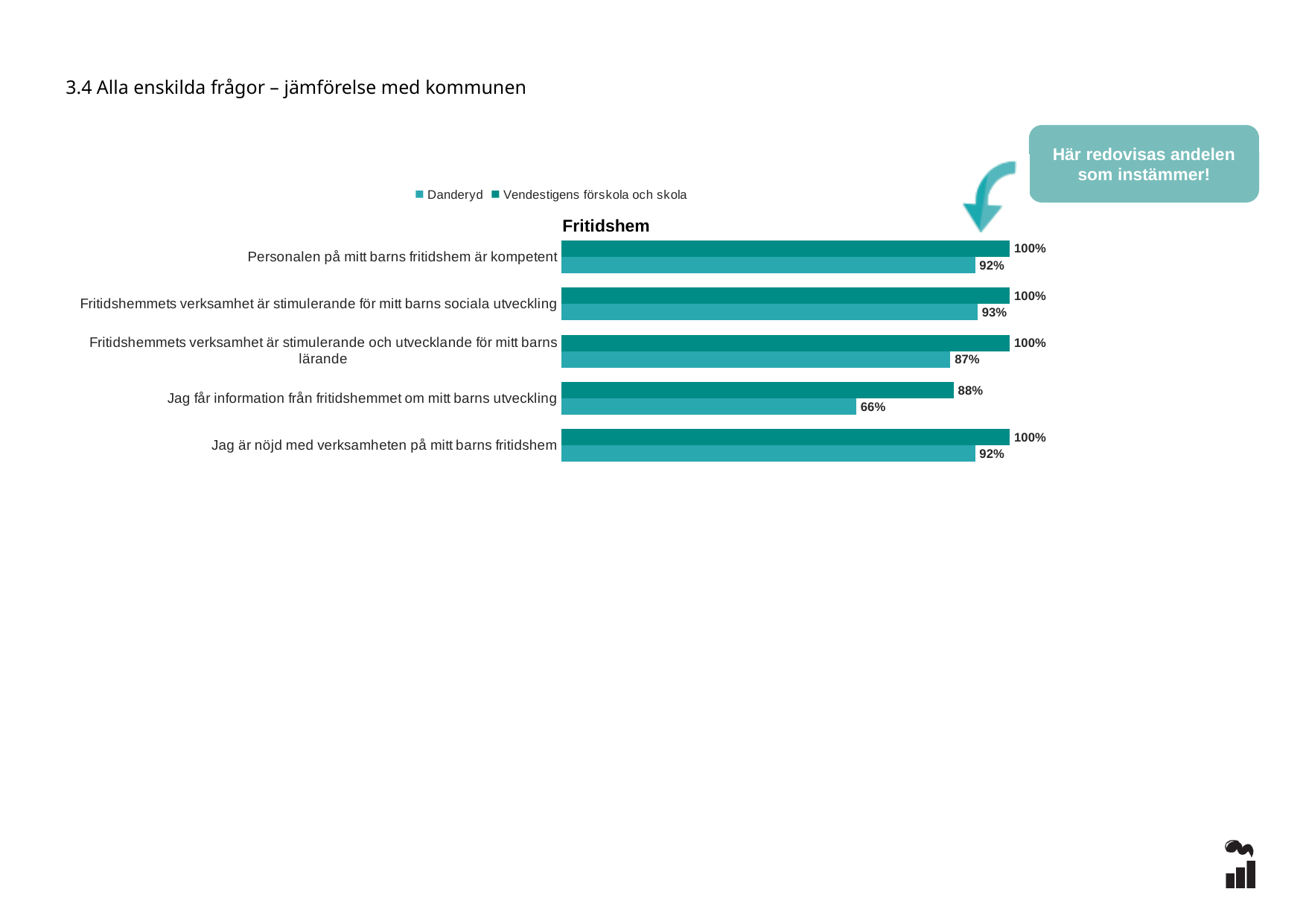
Which statement has the lowest Danderyd value? Jag får information från fritidshemmet om mitt barns utveckling What is the Danderyd value for "Jag får information från fritidshemmet om mitt barns utveckling"? 66% What is the Vendestigens förskola och skola value for "Jag får information från fritidshemmet om mitt barns utveckling"? 88% How many statements (categories) are plotted in the Fritidshem chart? 5 What is the difference between the Vendestigens förskola och skola and Danderyd values for "Jag får information från fritidshemmet om mitt barns utveckling"? 22 percentage points How many series does the legend of the Fritidshem chart list? 2 Which statement has the highest Danderyd value? Fritidshemmets verksamhet är stimulerande för mitt barns sociala utveckling What is the Danderyd value for "Fritidshemmets verksamhet är stimulerande och utvecklande för mitt barns lärande"? 87% For "Jag är nöjd med verksamheten på mitt barns fritidshem", which series has the larger value, Danderyd or Vendestigens förskola och skola? Vendestigens förskola och skola What does the callout box at the top right of the slide say? Här redovisas andelen som instämmer! What kind of chart is shown under the title "Fritidshem"? Bar chart What is the Danderyd value for "Fritidshemmets verksamhet är stimulerande för mitt barns sociala utveckling"? 93%